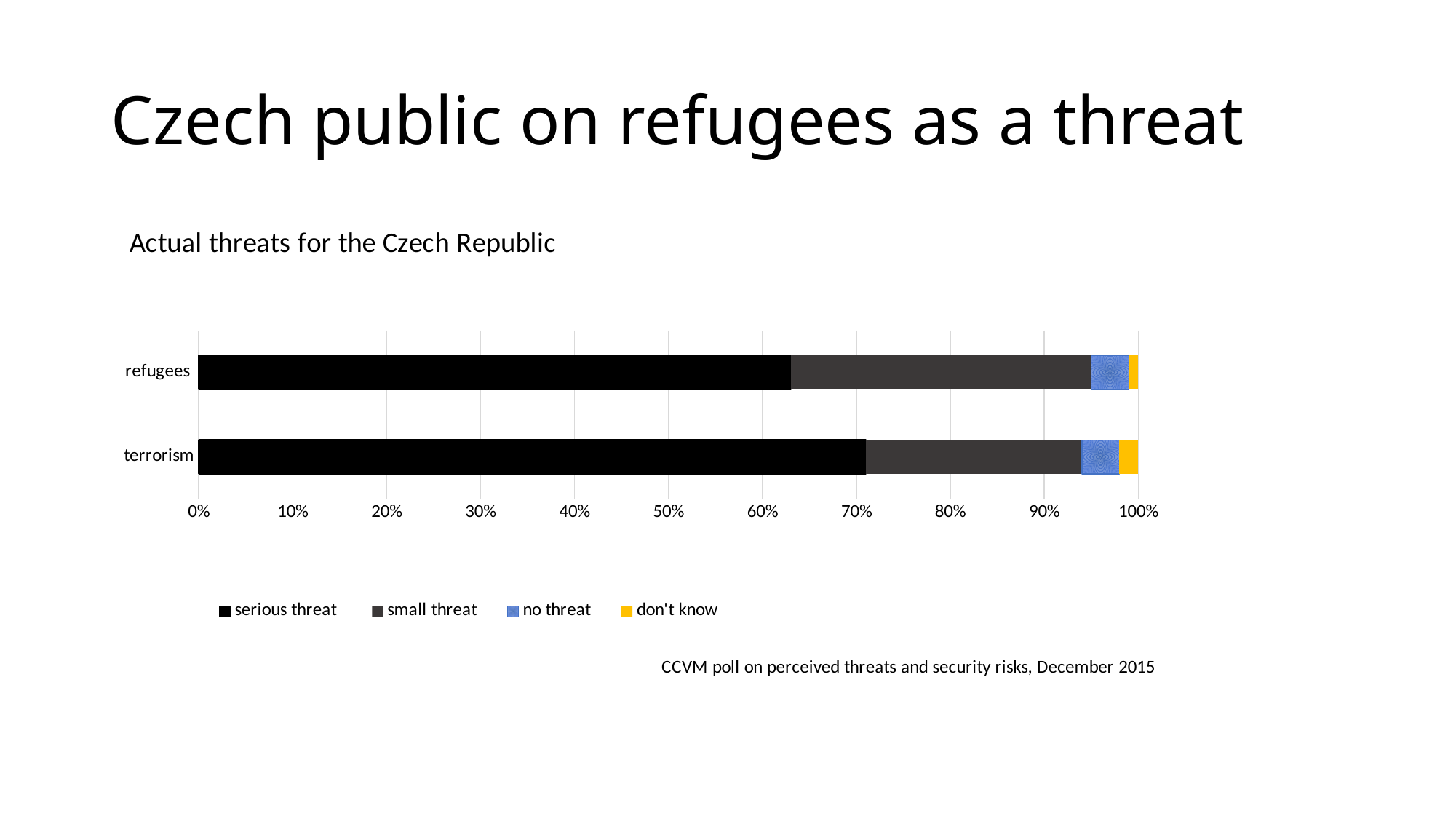
Which series is shown in yellow in the legend? don't know Which category has the highest 'serious threat' share? terrorism Which category has the larger 'small threat' share, refugees or terrorism? refugees Is the 'serious threat' value for refugees greater or less than 70%? less What is the title of the chart? Actual threats for the Czech Republic What kind of chart is shown on the slide? bar chart How many categories are plotted on the chart? 2 How many series does the legend list? 4 Which category has the larger 'serious threat' share, refugees or terrorism? terrorism Which category has the larger 'don't know' share, refugees or terrorism? terrorism Is the 'serious threat' value for refugees greater or less than 60%? greater